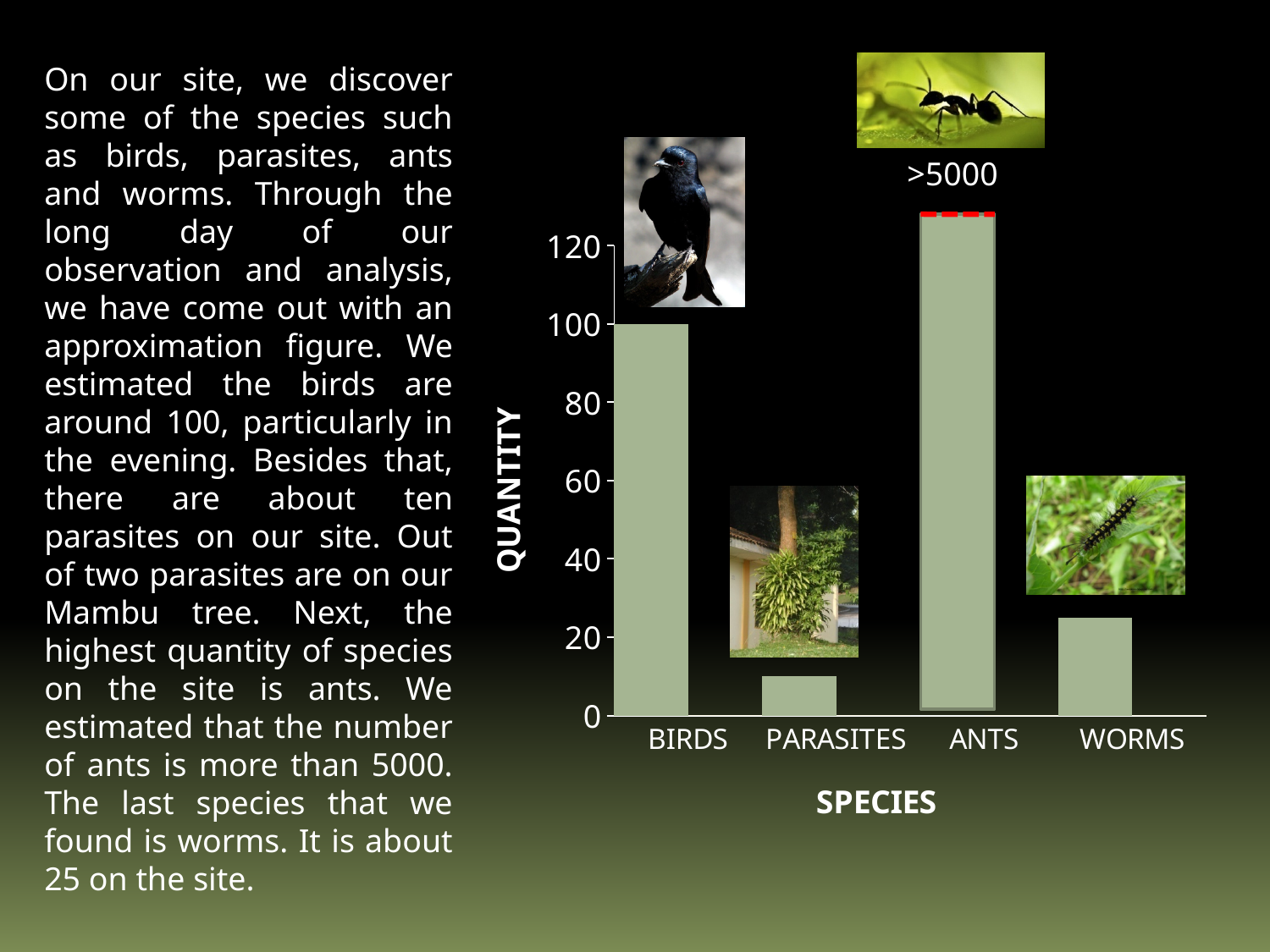
Which is larger in the chart, the value for BIRDS or the value for WORMS? BIRDS Which is larger in the chart, the value for PARASITES or the value for WORMS? WORMS Which species has the highest bar in the chart? ANTS What kind of chart is shown on the slide? bar chart Is the bar for ANTS greater or less than 120 on the axis? greater What label is printed above the ANTS bar in the chart? >5000 How many species categories are plotted on the x axis of the chart? 4 Is the value for WORMS greater or less than 40? less Is the value for PARASITES greater or less than 20? less Which species has the lowest bar in the chart? PARASITES What is the quantity shown for BIRDS in the chart? 100 What is the title of the vertical axis of the chart? QUANTITY